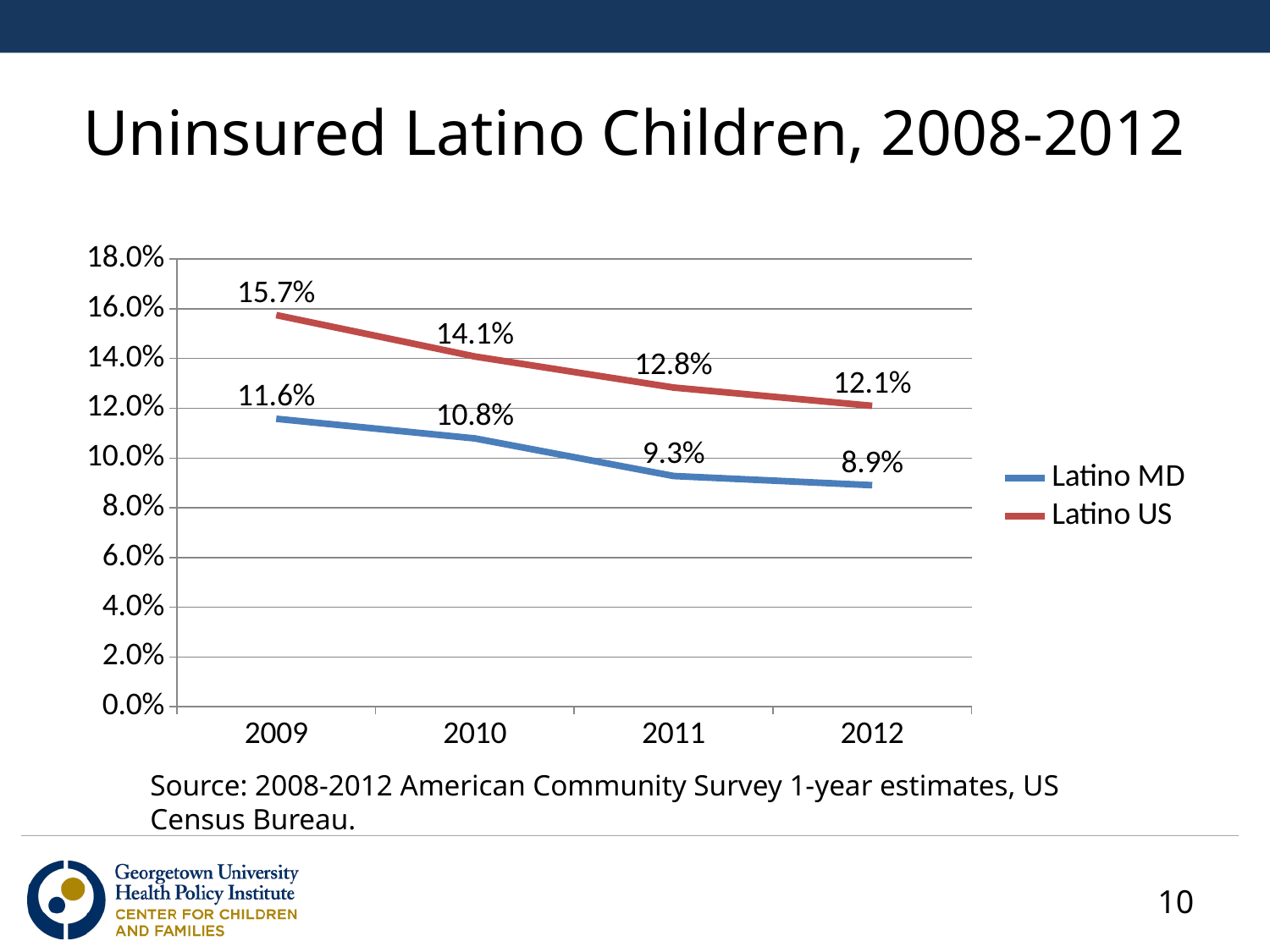
What is the value for Latino MD in 2009? 11.6% What is the difference between the Latino US and Latino MD values in 2009? 4.1% How many series does the legend list? 2 Do the Latino MD values rise or fall from 2009 to 2012? Fall What is the value for Latino US in 2010? 14.1% How many years are shown on the x axis? 4 What is the value for Latino MD in 2011? 9.3% In which year is the Latino US value highest? 2009 What is the value for Latino US in 2012? 12.1% Which is larger in 2012, the Latino MD value or the Latino US value? Latino US What kind of chart is shown on the slide? Line chart In which year is the Latino MD value lowest? 2012